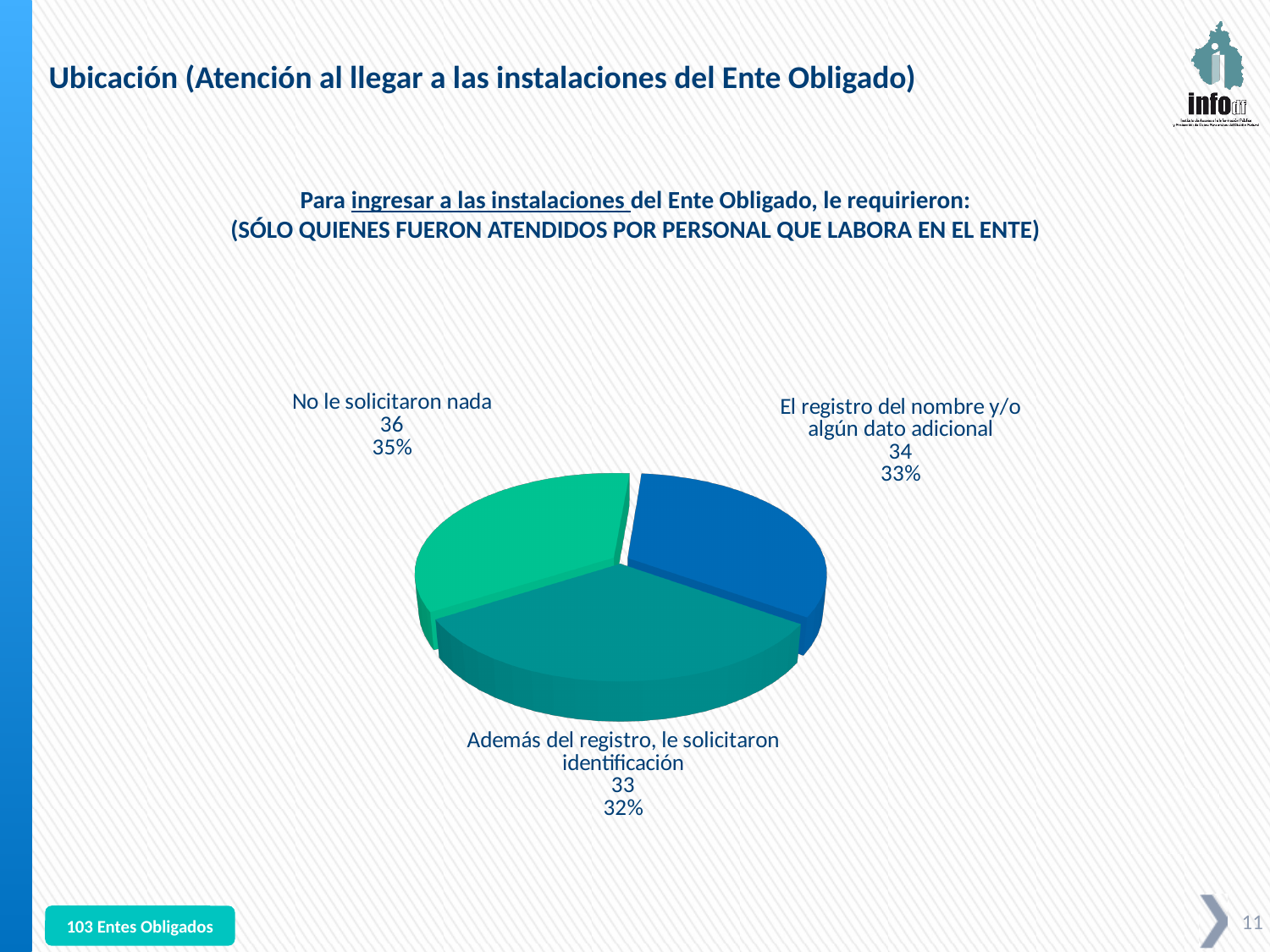
What share of the pie does "No le solicitaron nada" represent? 35% What is the total of the three values shown in the pie chart? 103 Which category has the lowest value? Además del registro, le solicitaron identificación What is the difference between the values for "No le solicitaron nada" and "Además del registro, le solicitaron identificación"? 3 Which category has the highest value? No le solicitaron nada What is the value for "No le solicitaron nada"? 36 What share of the pie does "Además del registro, le solicitaron identificación" represent? 32% What is the value for "Además del registro, le solicitaron identificación"? 33 What kind of chart is shown on the slide? pie chart How many slices does the pie chart have? 3 What share of the pie does "El registro del nombre y/o algún dato adicional" represent? 33% What is the value for "El registro del nombre y/o algún dato adicional"? 34